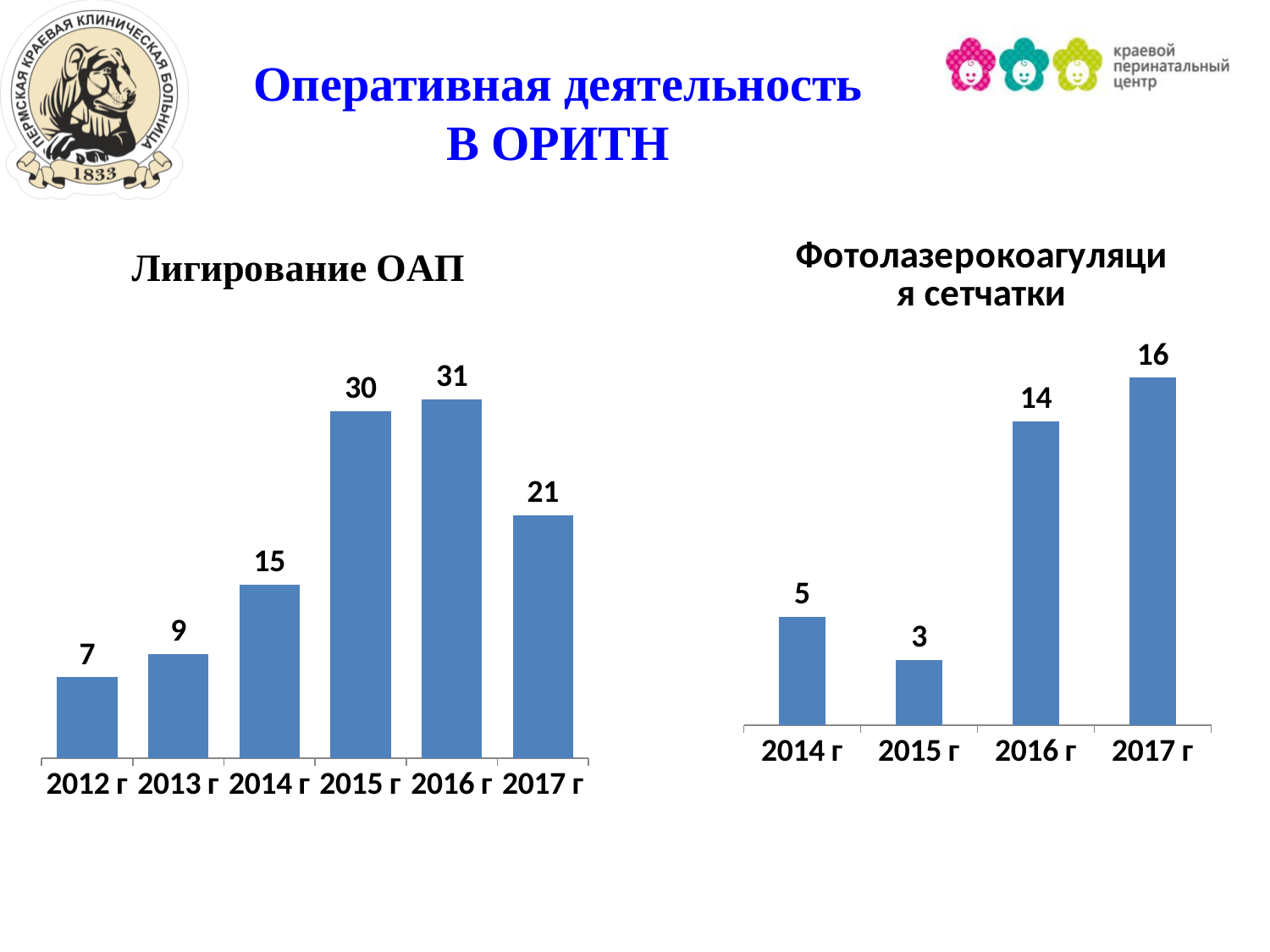
In the 'Фотолазерокоагуляция сетчатки' chart, which is larger, the value for 2014 г or 2015 г? 2014 г In the 'Фотолазерокоагуляция сетчатки' chart, what is the value for 2016 г? 14 What type of chart is the 'Лигирование ОАП' chart? Bar chart In the 'Лигирование ОАП' chart, what is the value for 2015 г? 30 In the 'Лигирование ОАП' chart, what is the value for 2012 г? 7 In the 'Лигирование ОАП' chart, how many years are shown on the x axis? 6 In the 'Лигирование ОАП' chart, which year has the lowest value? 2012 г In the 'Лигирование ОАП' chart, which year has the highest value? 2016 г In the 'Лигирование ОАП' chart, what is the difference between the values for 2016 г and 2017 г? 10 In the 'Фотолазерокоагуляция сетчатки' chart, which year has the lowest value? 2015 г In the 'Фотолазерокоагуляция сетчатки' chart, which year has the highest value? 2017 г In the 'Фотолазерокоагуляция сетчатки' chart, what is the difference between the values for 2017 г and 2014 г? 11